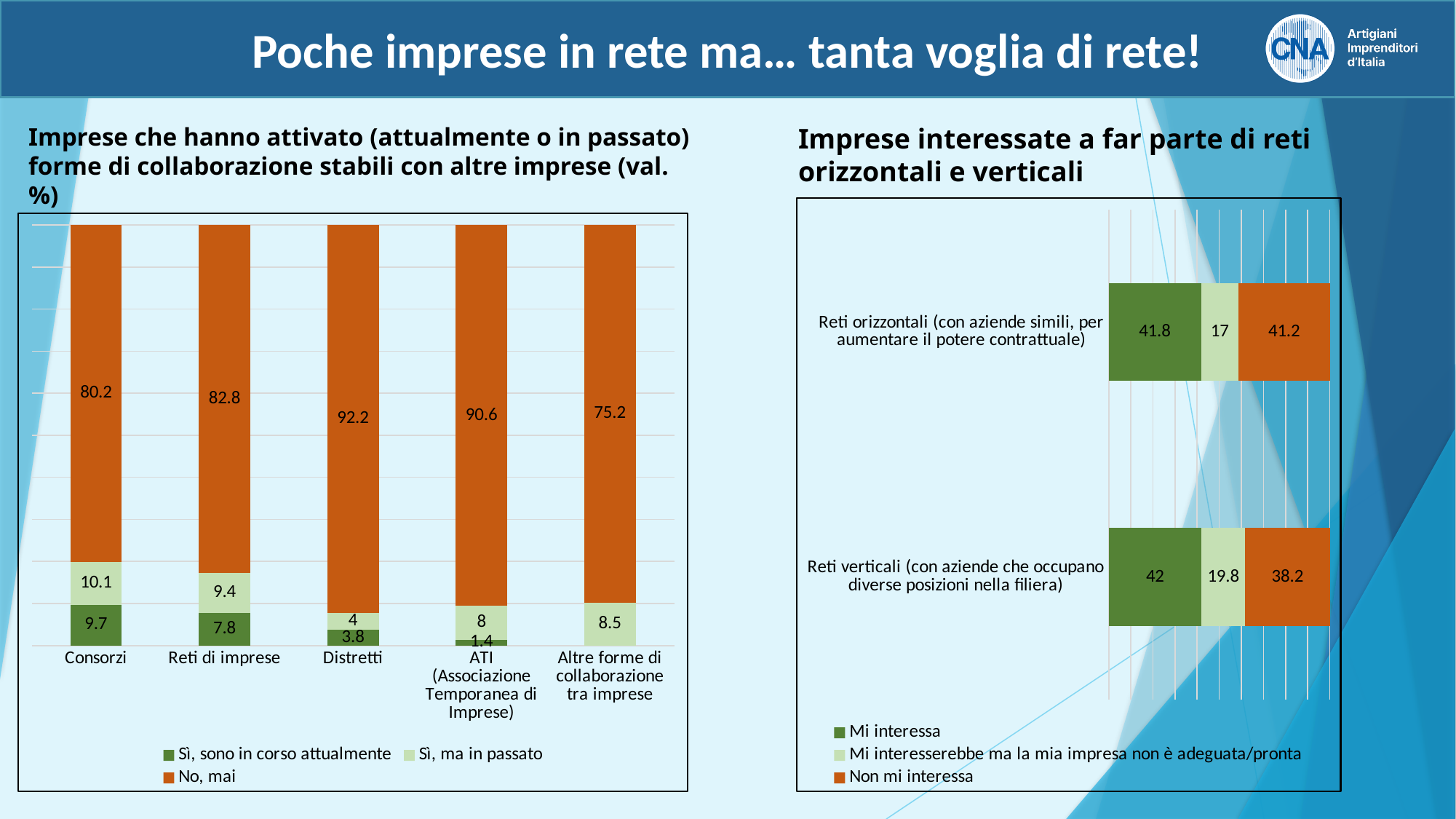
In the left chart, what is the value of "Sì, ma in passato" for ATI (Associazione Temporanea di Imprese)? 8 In the left chart, which category has the lowest value for "Sì, sono in corso attualmente"? ATI (Associazione Temporanea di Imprese) In the right chart, what is the "Mi interessa" value for Reti verticali? 42 In the right chart, how many series does the legend list? 3 In the left chart, what is the value of "Sì, sono in corso attualmente" for Consorzi? 9.7 In the right chart, which is larger: the "Mi interesserebbe ma la mia impresa non è adeguata/pronta" value for Reti orizzontali or for Reti verticali? Reti verticali What kind of chart is the right chart? Stacked horizontal bar chart In the left chart, what is the difference between the "No, mai" values for Reti di imprese and Consorzi? 2.6 In the right chart, what is the "Non mi interessa" value for Reti orizzontali? 41.2 In the left chart, how many categories are shown on the x axis? 5 In the left chart, what is the value of "No, mai" for Distretti? 92.2 In the left chart, which category has the highest value for "No, mai"? Distretti